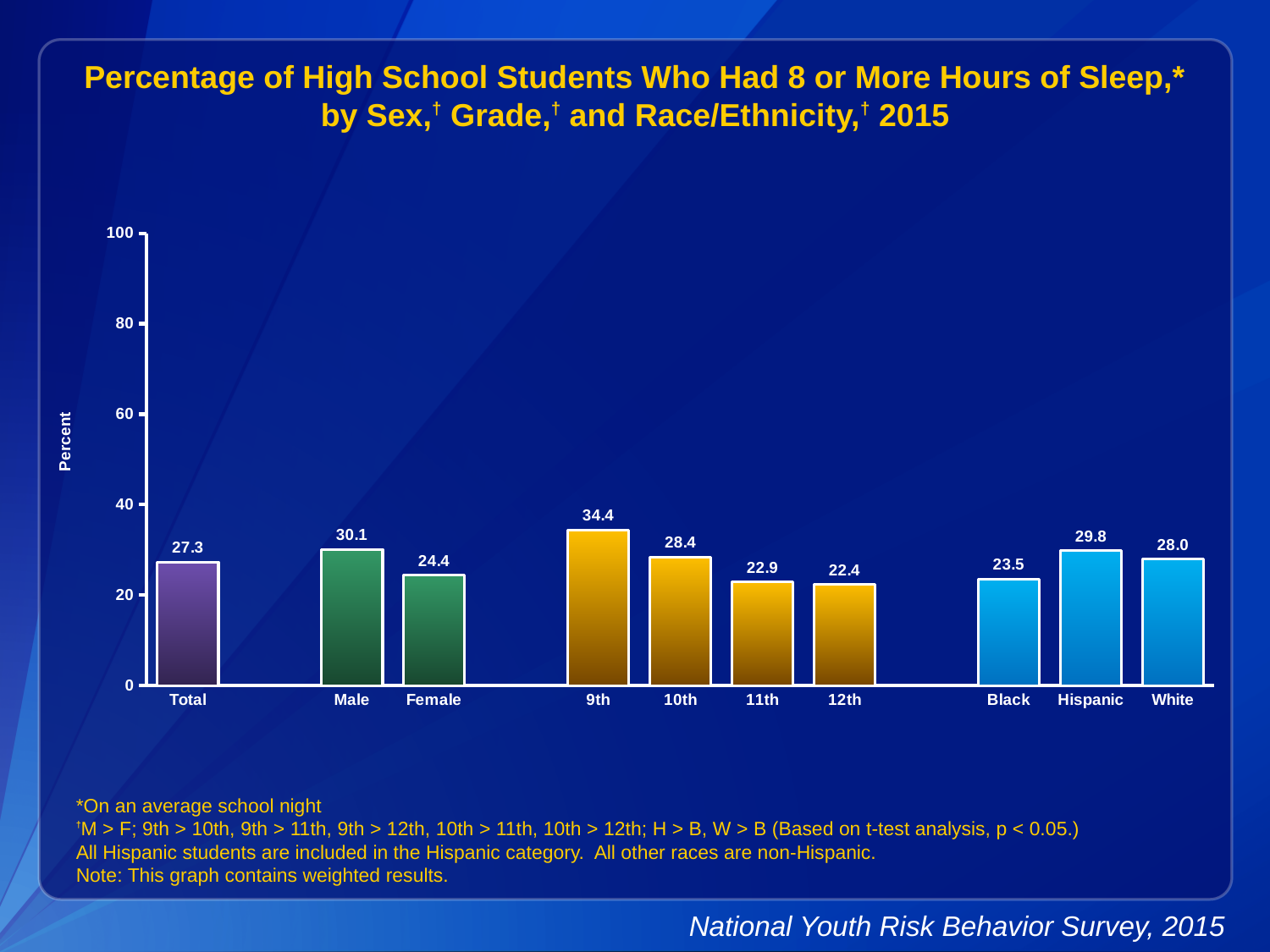
Is the value for 9th grade greater or less than 40? less What is the difference between the values for Male and Female? 5.7 Which category has the lowest value? 12th What is the value for Total? 27.3 Which category has the highest value? 9th What kind of chart is this? bar chart What is the difference between the values for 9th and 10th grade? 6.0 Which is larger, the value for White or the value for Black? White How many categories are shown on the x axis? 10 What is the value for Hispanic? 29.8 What is the value for 11th grade? 22.9 What is the value for Female? 24.4